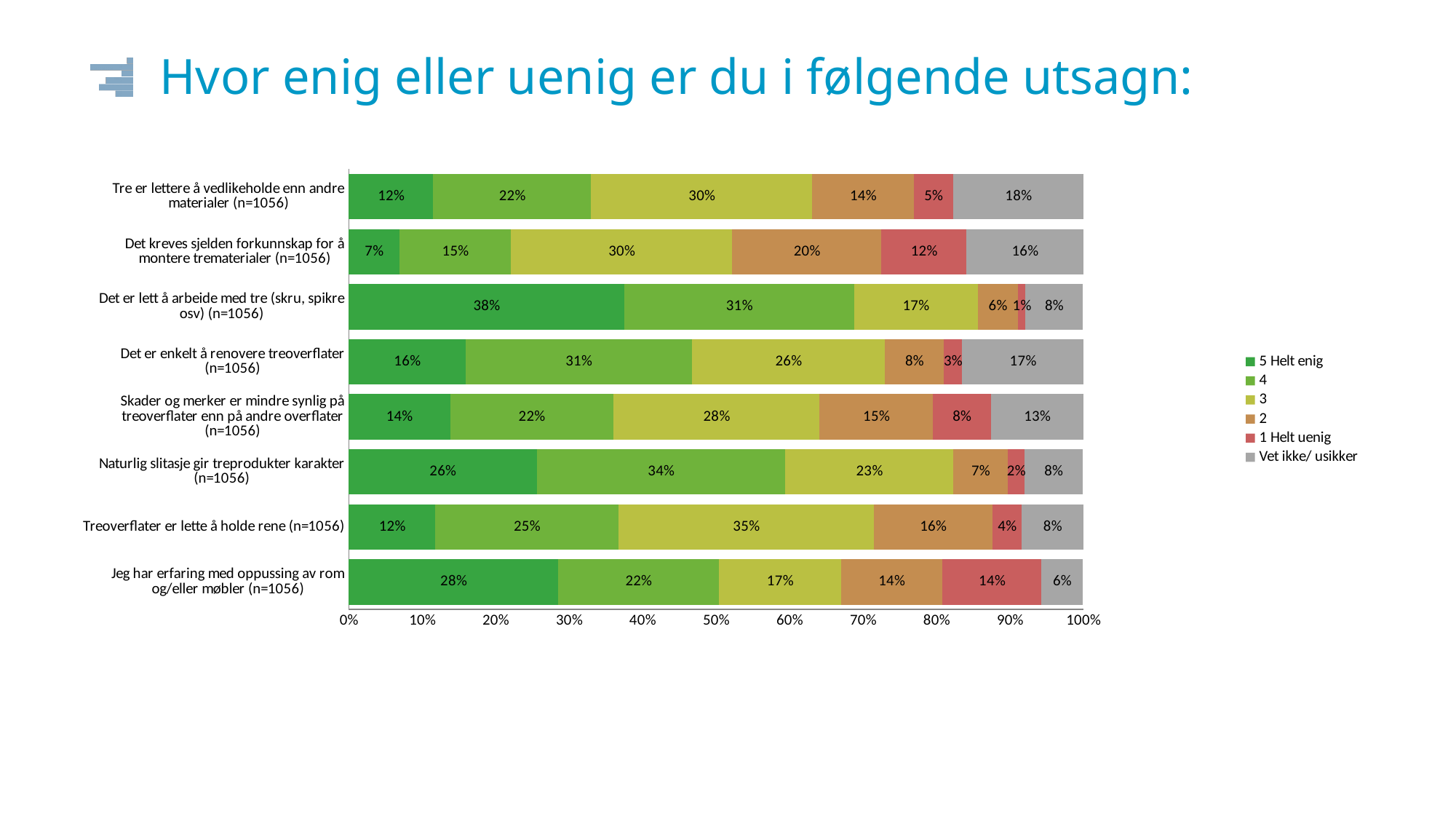
Which is larger: the "4" share for "Naturlig slitasje gir treprodukter karakter" or the "4" share for "Det er enkelt å renovere treoverflater"? Naturlig slitasje gir treprodukter karakter Which statement has the lowest "5 Helt enig" share? Det kreves sjelden forkunnskap for å montere trematerialer How many series does the legend list? 6 What is the difference between the "3" share for "Treoverflater er lette å holde rene" and the "3" share for "Jeg har erfaring med oppussing av rom og/eller møbler"? 18% How many statements are shown in the chart? 8 What percentage of respondents answered "5 Helt enig" to "Det er lett å arbeide med tre (skru, spikre osv)"? 38% What is the combined share of "5 Helt enig" and "4" for "Det er lett å arbeide med tre (skru, spikre osv)"? 69% What percentage answered "Vet ikke/ usikker" for "Tre er lettere å vedlikeholde enn andre materialer"? 18% What type of chart is shown on the slide? Stacked bar chart Which legend entry is shown in grey? Vet ikke/ usikker Which statement has the highest "5 Helt enig" share? Det er lett å arbeide med tre (skru, spikre osv) What is the "1 Helt uenig" share for "Jeg har erfaring med oppussing av rom og/eller møbler"? 14%